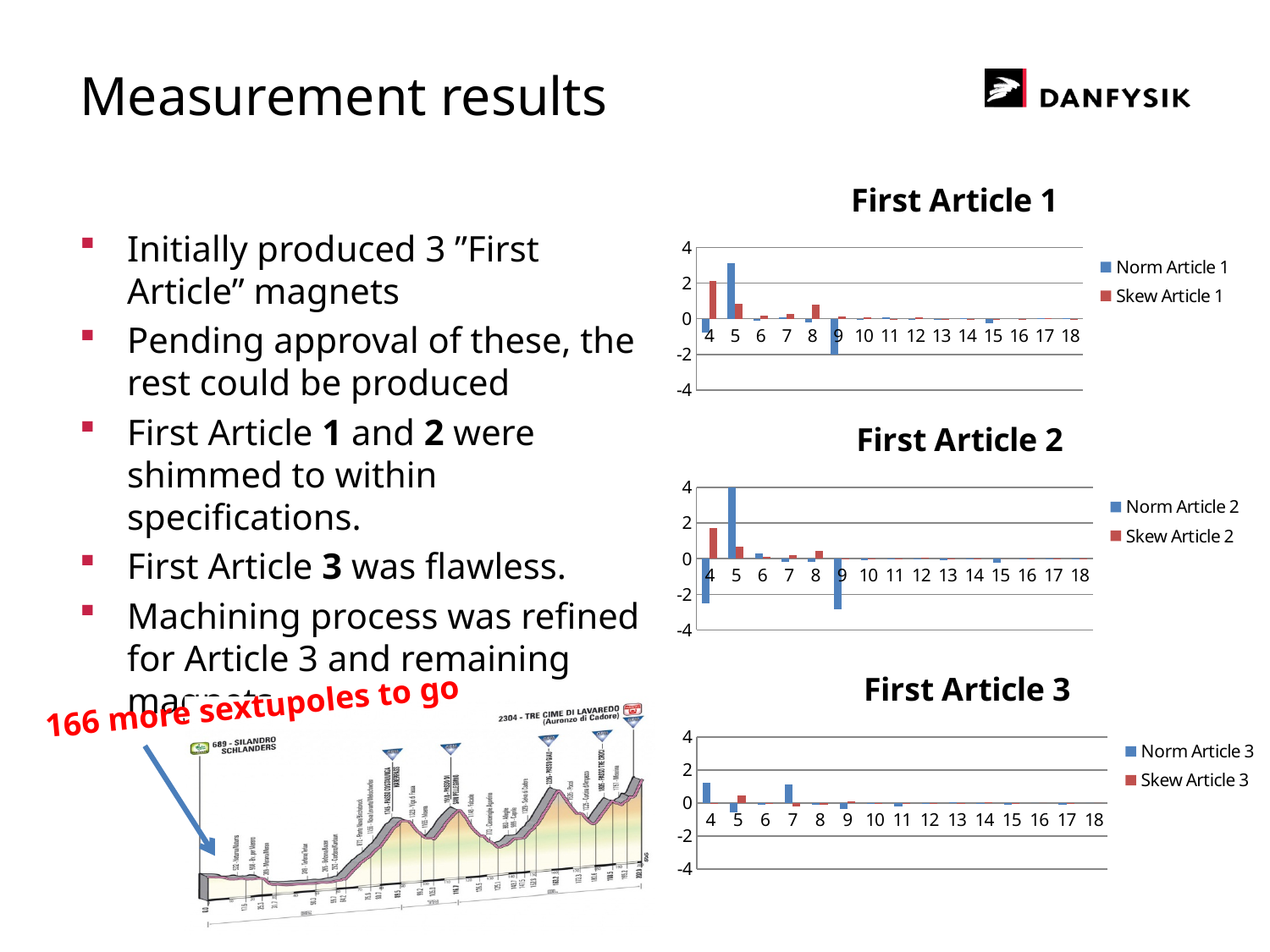
What kind of chart is the "First Article 1" chart? bar chart In the "First Article 1" chart, which category has the highest bar? 5 How many series does the legend of the "First Article 2" chart list? 2 What are the two legend entries of the "First Article 3" chart? Norm Article 3 and Skew Article 3 In the "First Article 1" chart, which is larger for category 5: Norm Article 1 or Skew Article 1? Norm Article 1 In the "First Article 2" chart, which category has the highest bar? 5 In the "First Article 2" chart, is the Norm Article 2 value for category 9 greater or less than -2? less How many categories are shown on the x axis of the "First Article 3" chart? 15 In the "First Article 1" chart, which category has the lowest bar? 9 In the "First Article 1" chart, is the Norm Article 1 value for category 5 greater or less than 2? greater In the "First Article 3" chart, is the Norm Article 3 value for category 4 greater or less than 2? less What is the title of the bottom chart on the slide? First Article 3